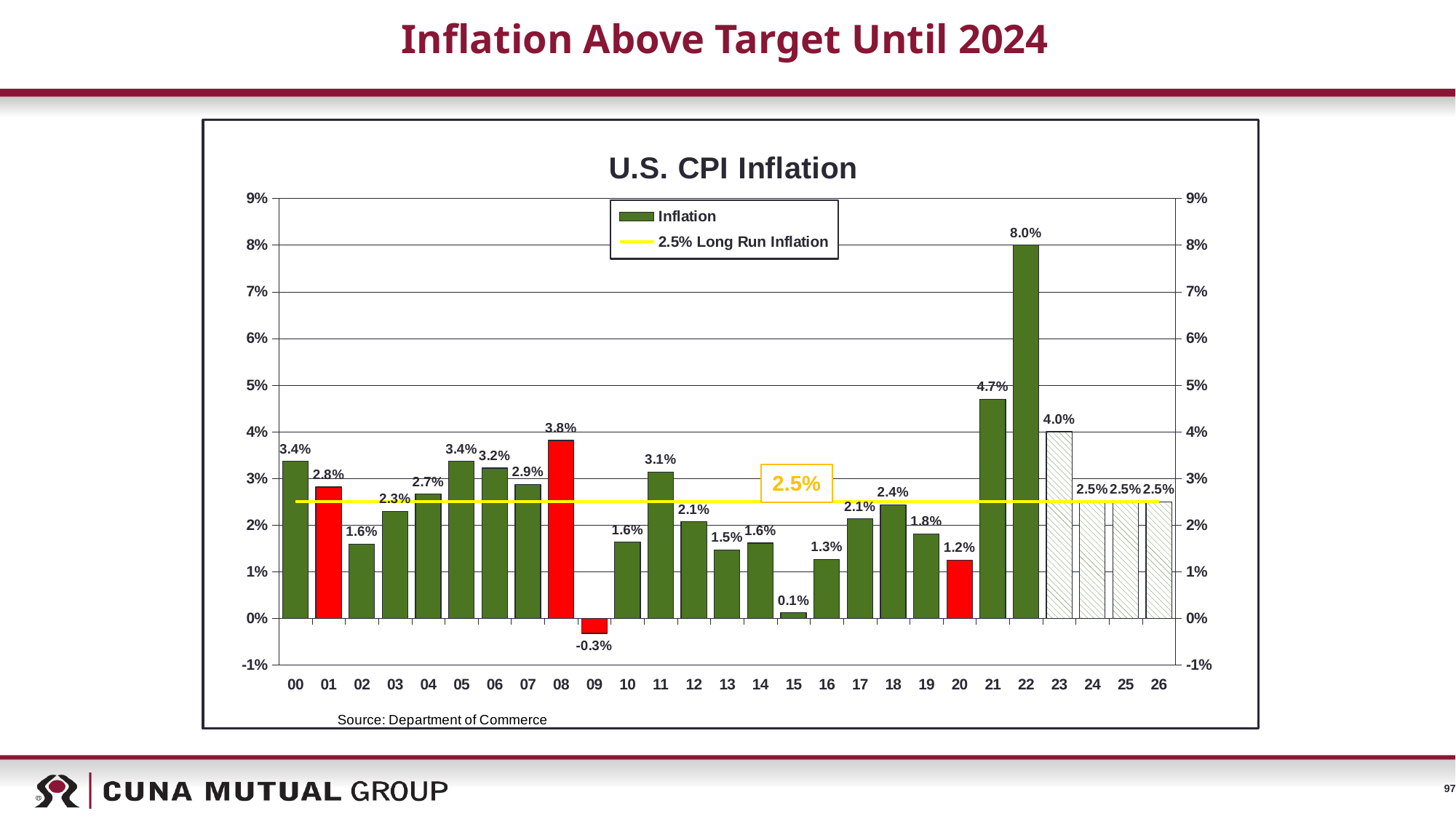
How many years are shown on the x axis of the chart? 27 What is the inflation value shown for 15? 0.1% What is the difference between the inflation values for 22 and 21? 3.3 percentage points What is the U.S. CPI inflation value shown for 22? 8.0% Which year has the higher inflation value, 08 or 11? 08 Which year has the lowest inflation value on the chart? 09 What is the inflation value shown for 09? -0.3% What value does the yellow horizontal line in the chart represent? 2.5% Long Run Inflation Do the inflation values rise or fall from 20 to 22? Rise How many entries does the chart legend list? 2 Which year has the highest inflation value on the chart? 22 What kind of chart is used to show U.S. CPI Inflation? Bar chart